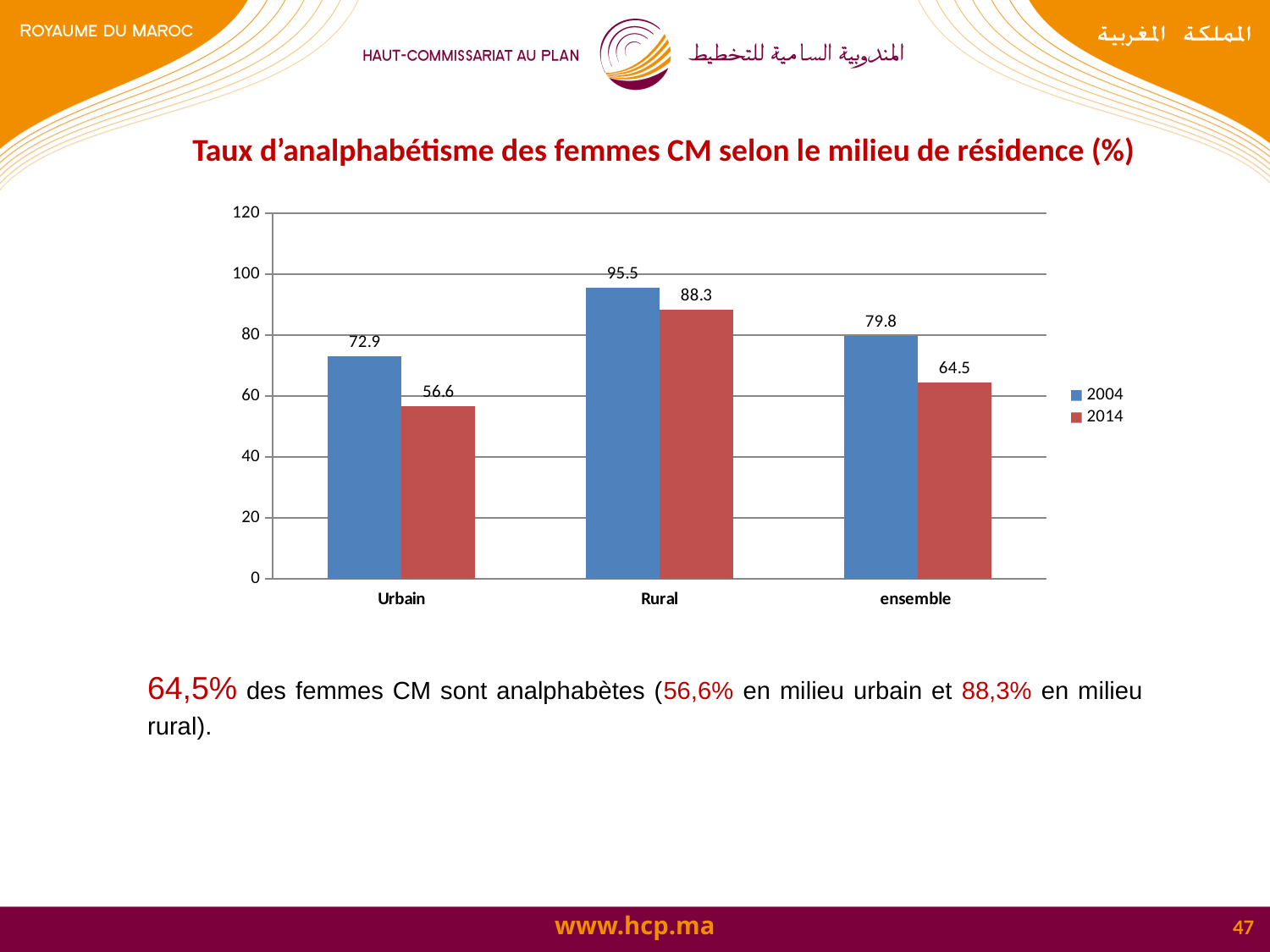
Which is larger, the 2004 value for Rural or the 2004 value for ensemble? Rural What is the difference between the 2004 and 2014 values for Urbain? 16.3 Which category has the lowest value in the 2014 series? Urbain How many categories are shown on the x axis? 3 Which category has the highest value in the 2004 series? Rural What kind of chart is shown on the slide? bar chart What is the difference between the 2004 and 2014 values for ensemble? 15.3 What is the value for ensemble in the 2014 series? 64.5 Is the 2014 value for Rural greater or less than 80? greater How many series does the legend list? 2 What is the value for Urbain in the 2004 series? 72.9 What is the value for Rural in the 2014 series? 88.3